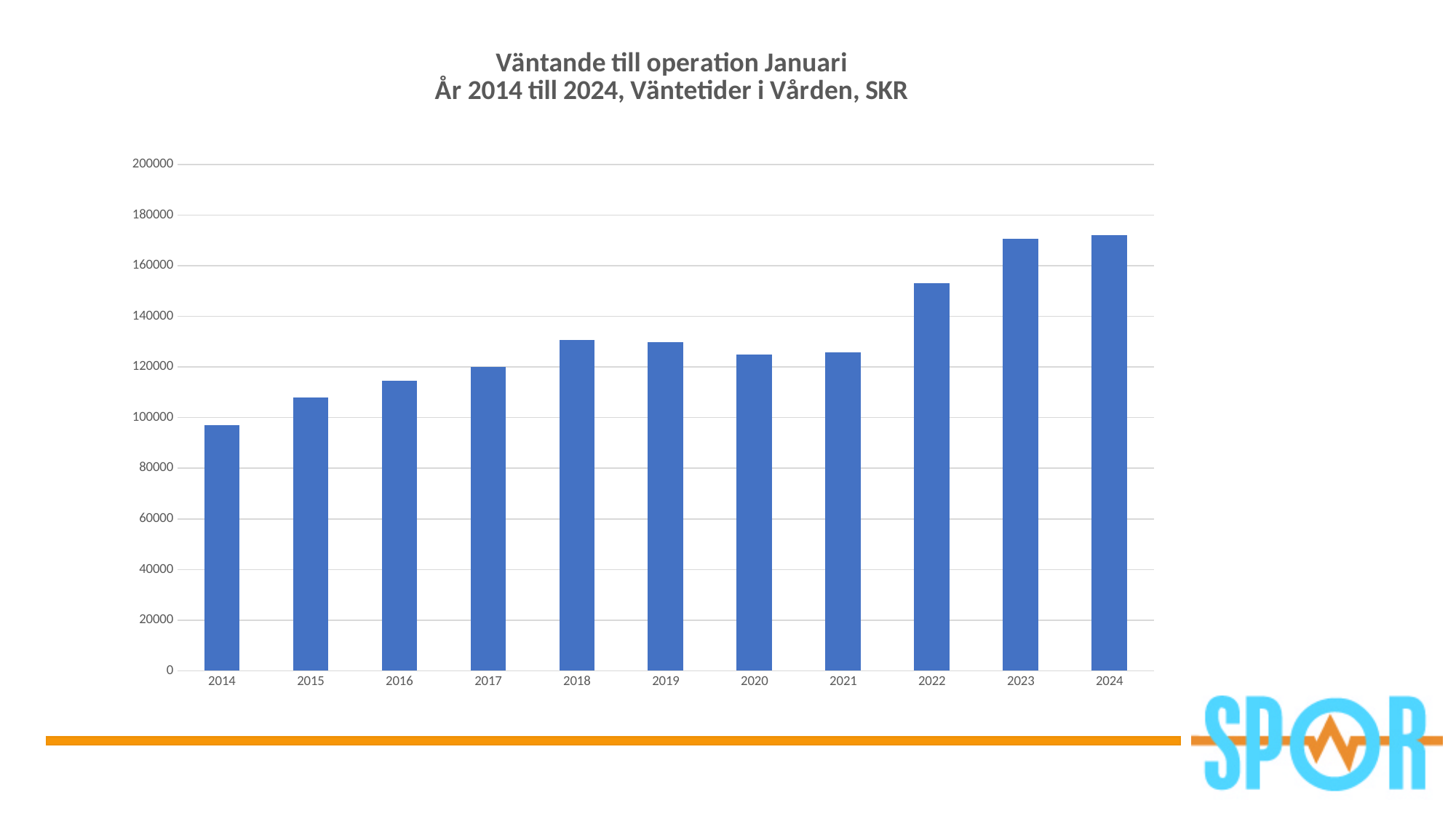
Is the value for 2022 greater or less than 140000? greater What kind of chart is shown on the slide? bar chart How many years are shown on the x axis of the chart? 11 What is the first line of the chart's title? Väntande till operation Januari Is the value for 2018 greater or less than 120000? greater Is the value for 2016 greater or less than 120000? less Which year has the lowest value in the chart? 2014 Which is larger, the value for 2018 or the value for 2020? 2018 Do the values generally rise or fall from 2014 to 2024? rise Which is larger, the value for 2021 or the value for 2022? 2022